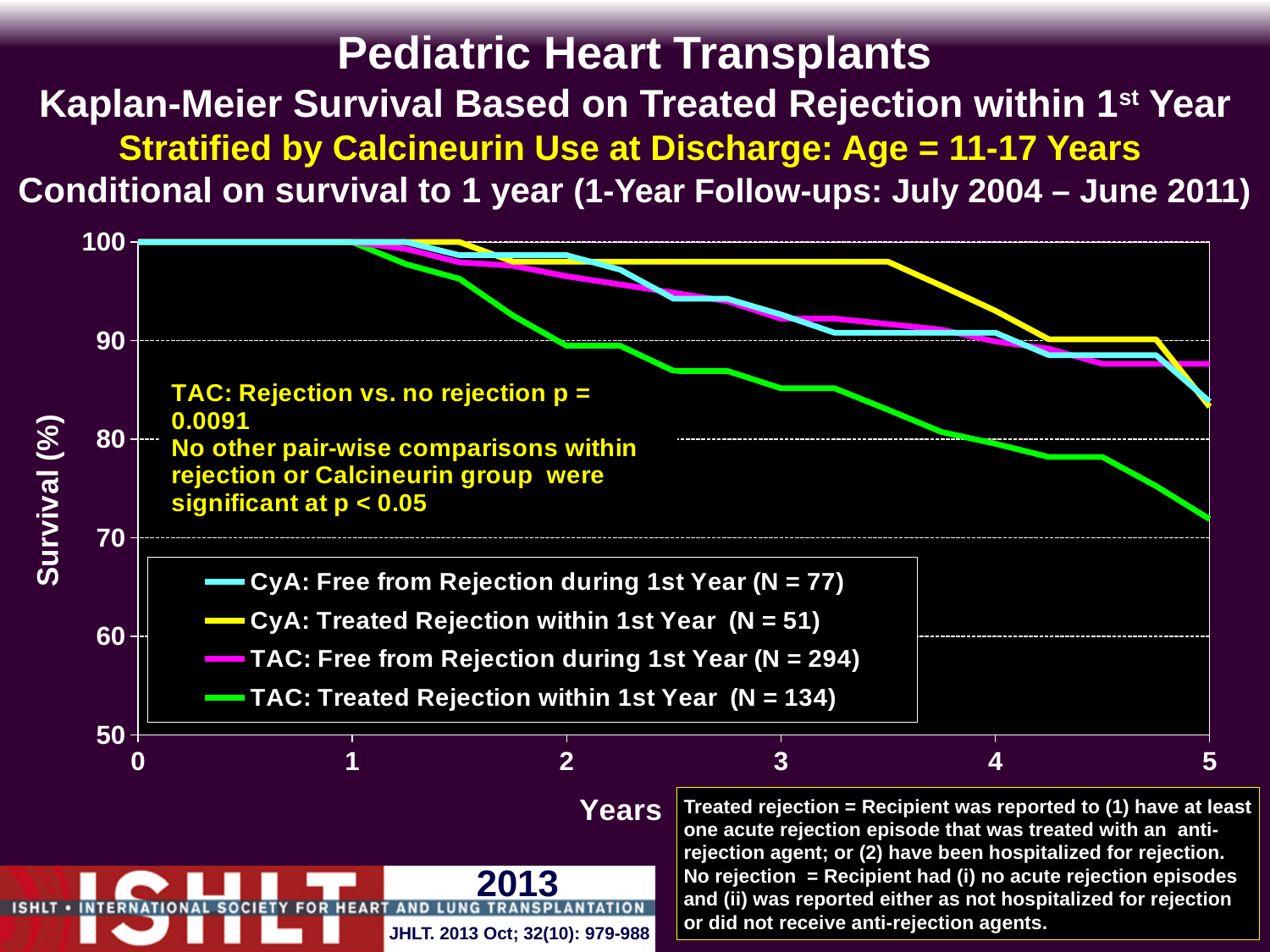
What is the label of the x axis? Years Is the survival for TAC: Treated Rejection within 1st Year at 5 years greater or less than 70? greater Is the survival for CyA: Treated Rejection within 1st Year at 3 years greater or less than 90? greater Which series has the lowest survival at 5 years? TAC: Treated Rejection within 1st Year (N = 134) What kind of chart is shown on the slide? line chart Is the survival for TAC: Treated Rejection within 1st Year at 3 years greater or less than 80? greater What is the p-value given for TAC rejection vs. no rejection? 0.0091 How many series does the legend list? 4 At 5 years, which has higher survival: TAC: Free from Rejection during 1st Year or TAC: Treated Rejection within 1st Year? TAC: Free from Rejection during 1st Year What is the label of the y axis? Survival (%) Do the survival curves rise or fall as years increase? fall